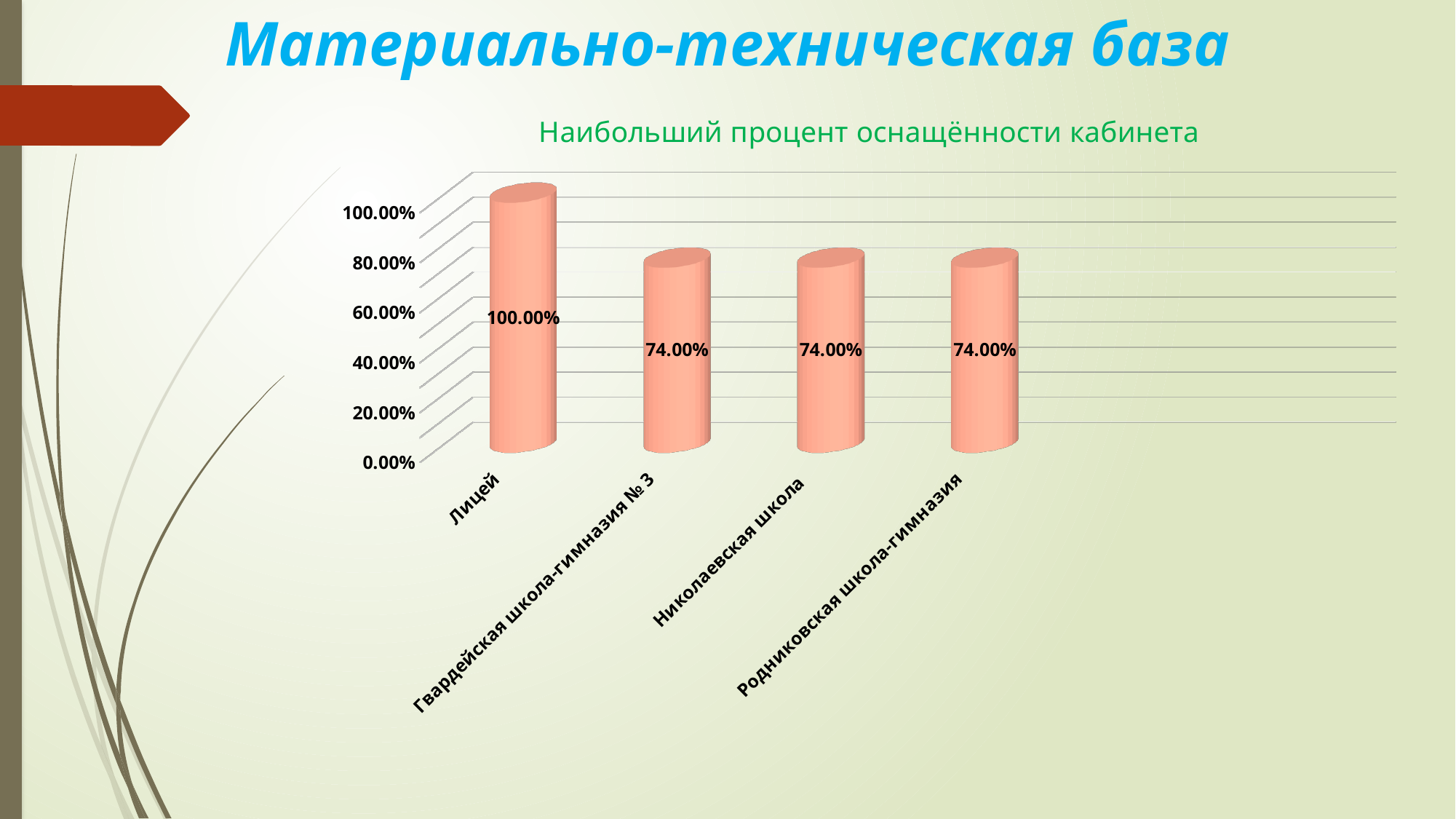
Which is larger, the value for Лицей or the value for Родниковская школа-гимназия? Лицей Is the value for Гвардейская школа-гимназия № 3 greater or less than 80.00%? less How many categories are shown on the chart? 4 What is the value for Николаевская школа? 74.00% What is the value for Лицей? 100.00% Which category has the highest value? Лицей What is the value for Родниковская школа-гимназия? 74.00% How many categories have a value of 74.00%? 3 What is the title of the chart? Наибольший процент оснащённости кабинета What is the value for Гвардейская школа-гимназия № 3? 74.00% What is the difference between the values for Лицей and Николаевская школа? 26.00% What kind of chart is shown on the slide? bar chart